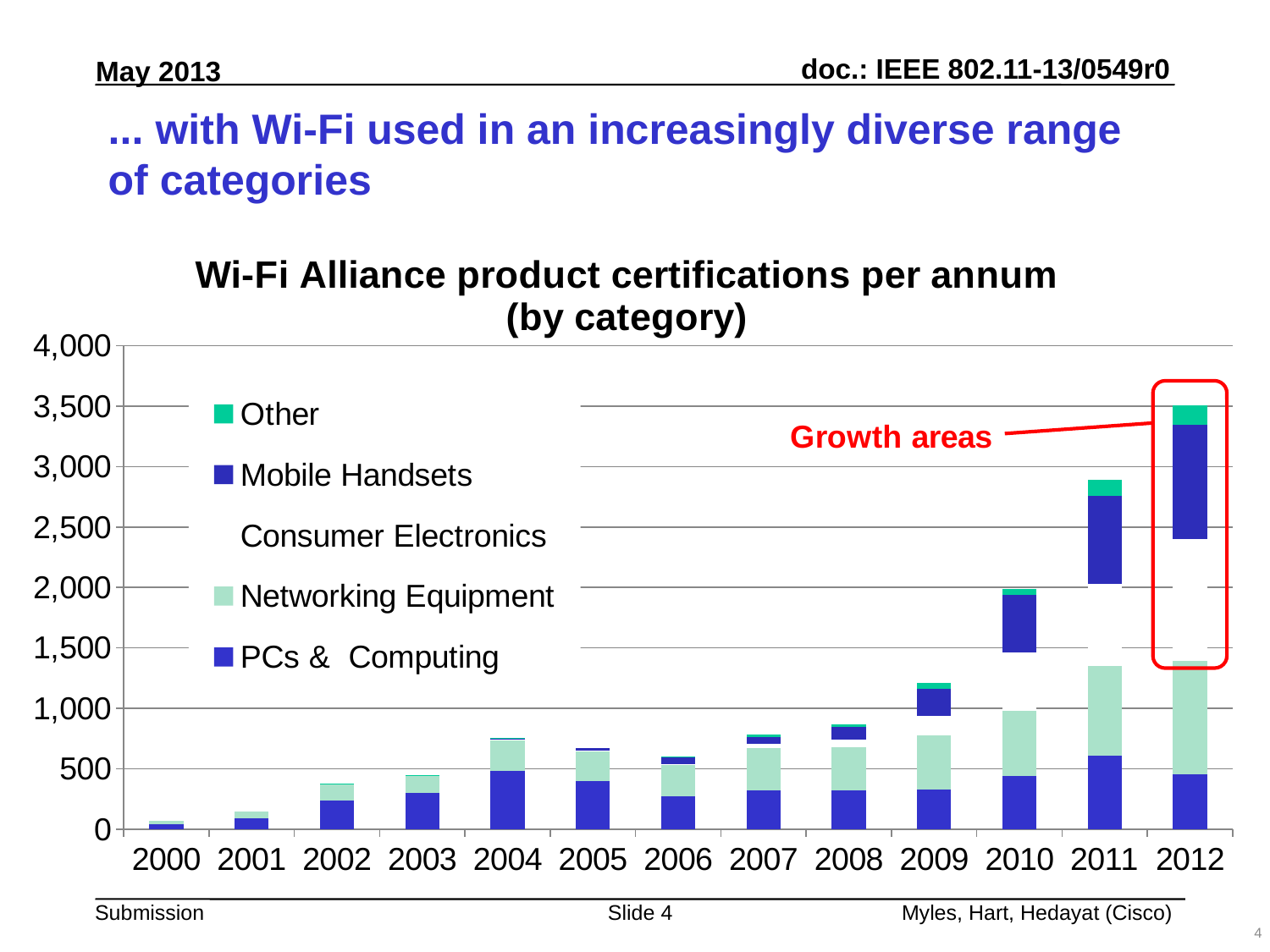
What kind of chart is shown on the slide? Stacked bar chart How many years are shown along the x axis of the chart? 13 Is the total value for 2011 greater or less than 2,500? greater What is the title of the chart? Wi-Fi Alliance product certifications per annum (by category) Do the total certifications per annum generally rise or fall from 2000 to 2012? rise Is the total value for 2008 greater or less than 1,000? less Which year has the lowest total number of Wi-Fi Alliance product certifications? 2000 Which year has the highest total number of Wi-Fi Alliance product certifications? 2012 Is the total value for 2000 greater or less than 500? less Which year has a larger total, 2009 or 2008? 2009 How many series does the chart's legend list? 5